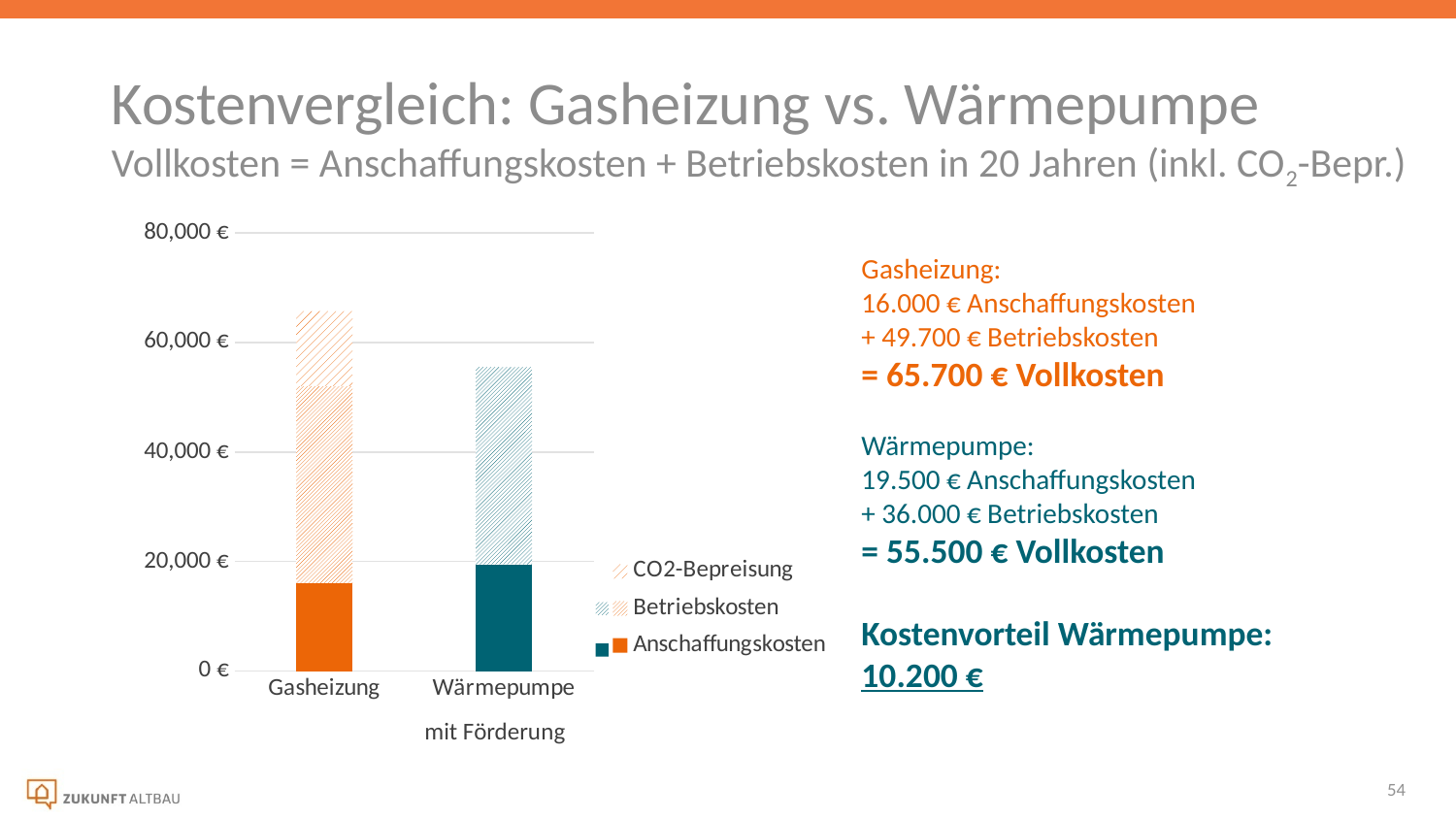
Which category has the higher total bar, Gasheizung or Wärmepumpe? Gasheizung What is the Kostenvorteil (cost advantage) of the Wärmepumpe stated on the slide? 10.200 € How many series does the chart legend list? 3 Which series is shown with solid fill in the chart legend? Anschaffungskosten Is the total bar for Gasheizung greater or less than 60,000 €? greater How many categories are shown on the x axis of the chart? 2 Which category has the lower total bar? Wärmepumpe What kind of chart is shown on the slide? stacked bar chart According to the text on the slide, what are the Vollkosten for Gasheizung? 65.700 € Is the Anschaffungskosten segment for Gasheizung greater or less than 20,000 €? less According to the text on the slide, what are the Vollkosten for Wärmepumpe? 55.500 € Is the total bar for Wärmepumpe greater or less than 60,000 €? less